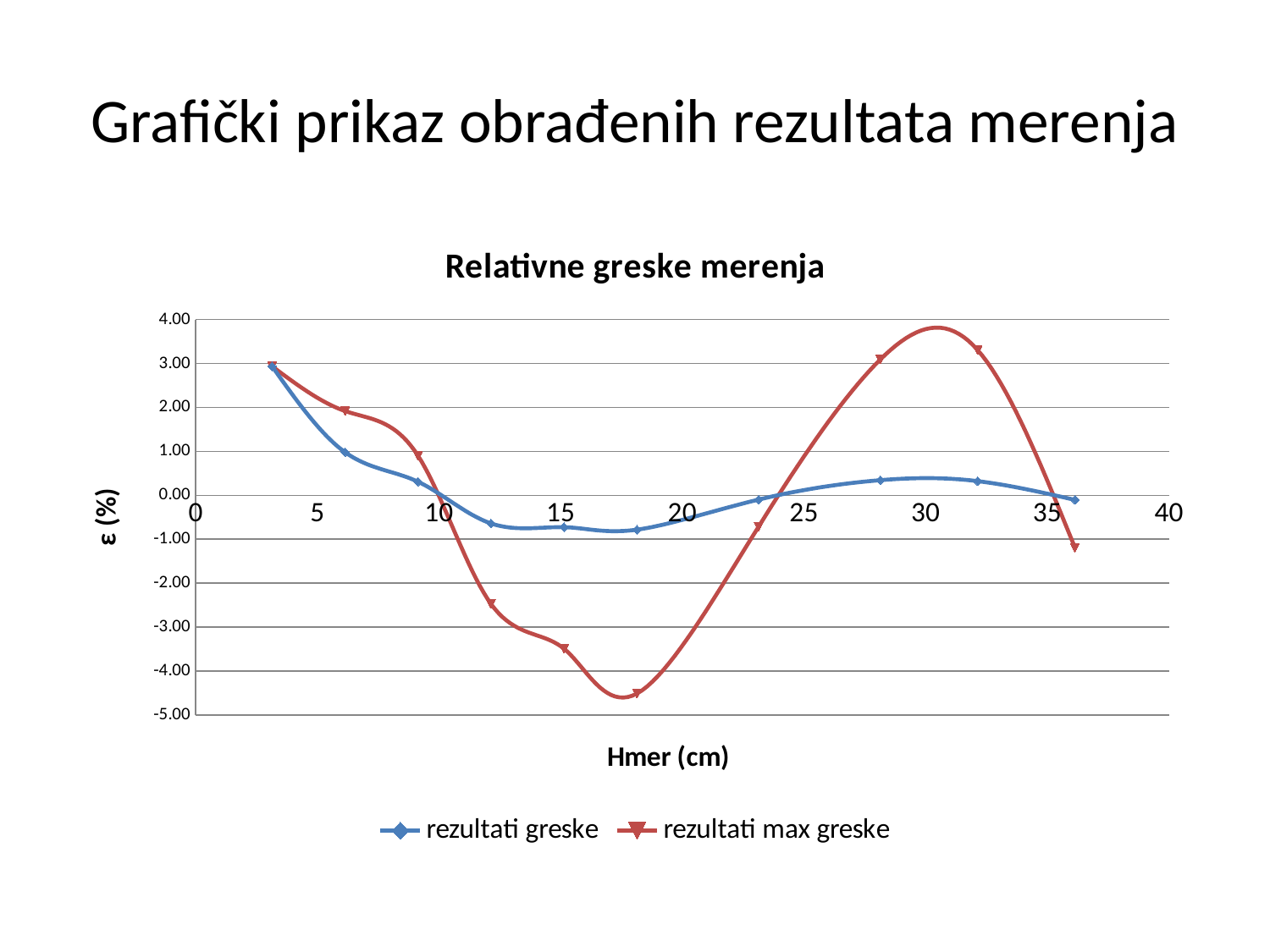
Does the 'rezultati greske' series rise or fall between about 3 cm and 18 cm? fall At about 28 cm, which series has the higher value, 'rezultati greske' or 'rezultati max greske'? rezultati max greske What is the title of the chart? Relativne greske merenja Is the value of the 'rezultati greske' series at about 6 cm greater or less than 0.00? greater Is the value of the 'rezultati max greske' series at about 18 cm greater or less than -4.00? less What kind of chart is shown on the slide? line chart Is the value of the 'rezultati max greske' series at about 15 cm greater or less than -3.00? less At about 18 cm, which series has the higher value, 'rezultati greske' or 'rezultati max greske'? rezultati greske What is the label of the x axis? Hmer (cm) How many series does the legend list? 2